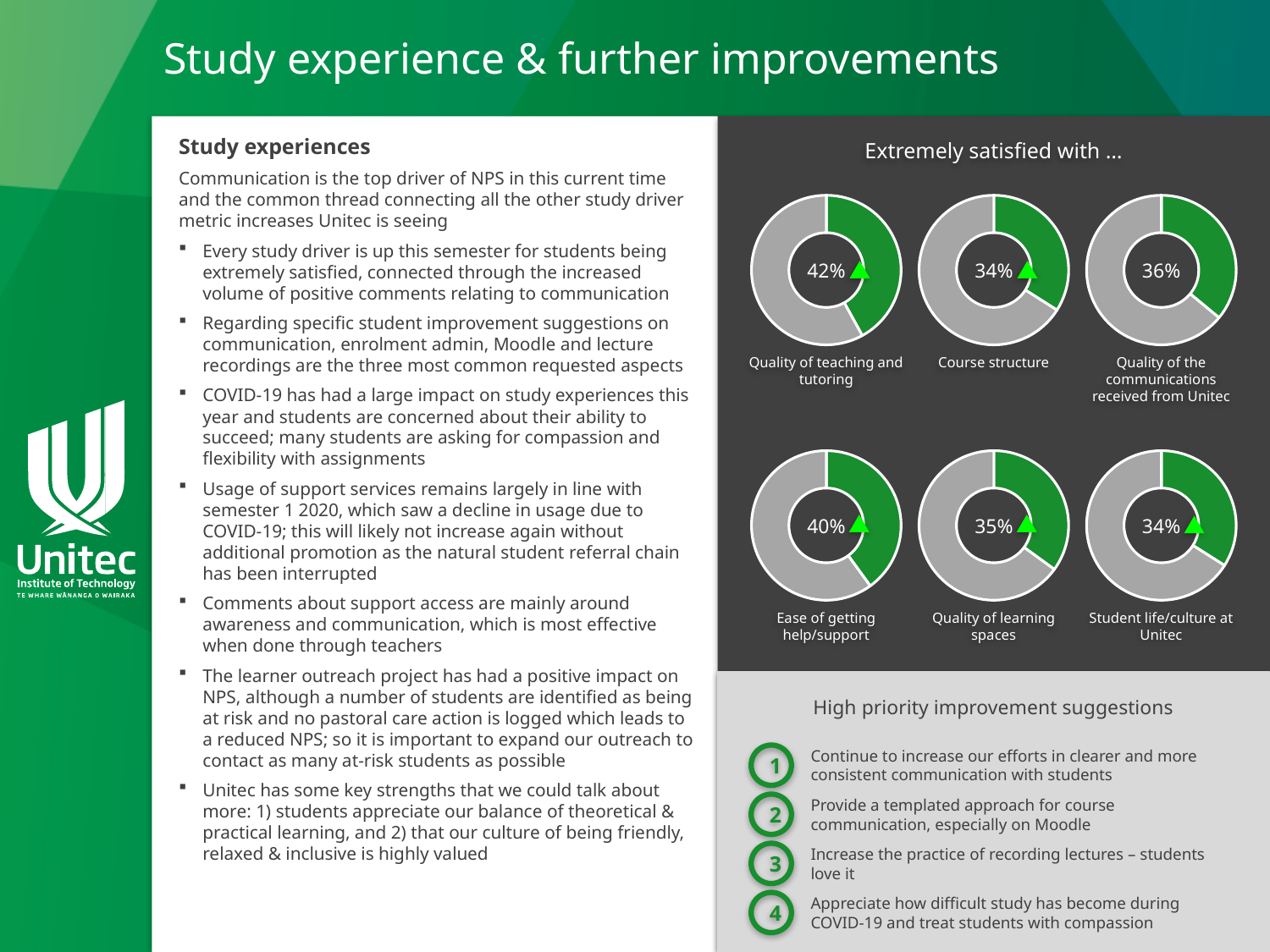
What is the title above the six donut charts on the slide? Extremely satisfied with ... In the 'Extremely satisfied with ...' charts, what percentage is shown for Quality of teaching and tutoring? 42% In the 'Extremely satisfied with ...' charts, what percentage is shown for Quality of the communications received from Unitec? 36% Among the 'Extremely satisfied with ...' charts, which aspect has the highest percentage? Quality of teaching and tutoring How many donut charts are shown under 'Extremely satisfied with ...'? 6 What kind of chart is used to show the 'Extremely satisfied with ...' percentages? Donut (pie) chart In the 'Extremely satisfied with ...' charts, what percentage is shown for Ease of getting help/support? 40% In the 'Extremely satisfied with ...' charts, which is larger: the percentage for Ease of getting help/support or for Quality of learning spaces? Ease of getting help/support In the 'Extremely satisfied with ...' charts, what percentage is shown for Course structure? 34% In the 'Extremely satisfied with ...' charts, what is the difference in percentage points between Quality of teaching and tutoring and Course structure? 8 percentage points In the 'Extremely satisfied with ...' charts, what percentage is shown for Student life/culture at Unitec? 34% In the 'Extremely satisfied with ...' charts, what percentage is shown for Quality of learning spaces? 35%